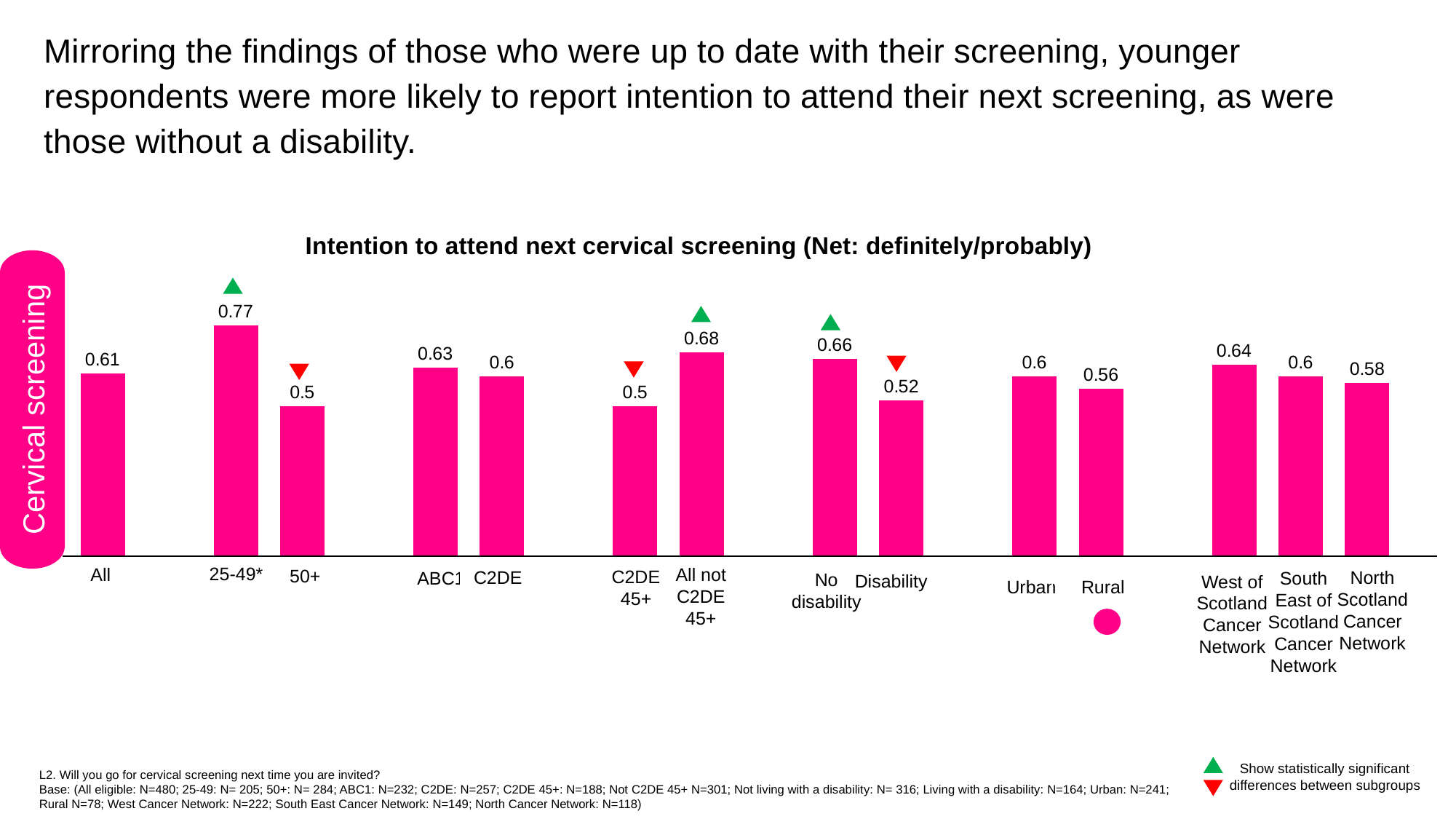
Which has the larger value, Urban or Rural? Urban What is the title of the chart? Intention to attend next cervical screening (Net: definitely/probably) Which has the larger value, C2DE 45+ or All not C2DE 45+? All not C2DE 45+ What is the difference between the values for No disability and Disability? 0.14 What is the value for the West of Scotland Cancer Network? 0.64 How many bars are plotted in the chart? 14 Which group has the highest value in the chart? 25-49* What type of chart is shown on the slide? Bar chart What is the value for the 25-49* group in the chart? 0.77 What is the value for respondents with a disability? 0.52 What is the difference between the values for 25-49* and 50+? 0.27 What is the value for the All group? 0.61